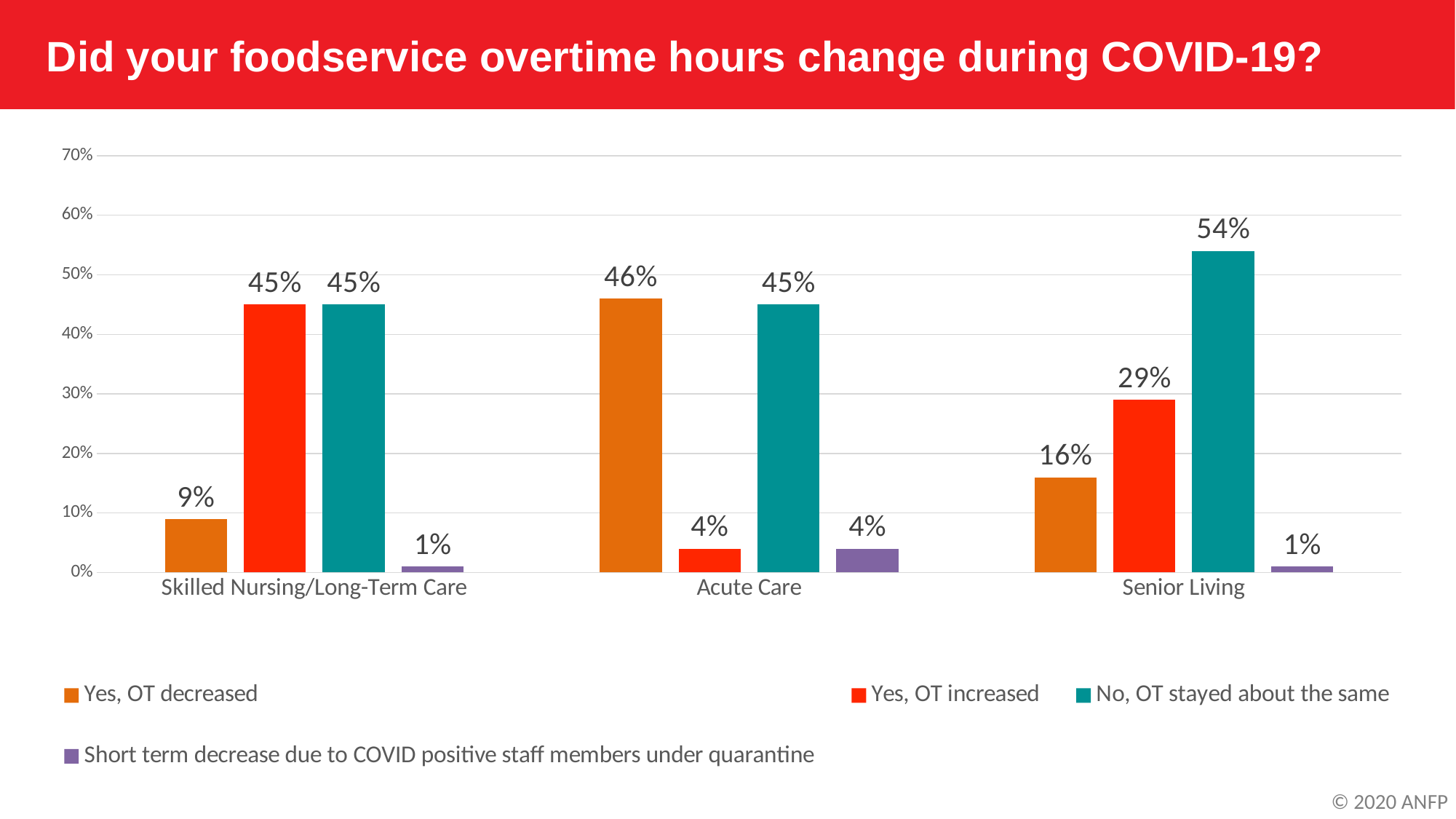
What is the value for 'No, OT stayed about the same' in Senior Living? 54% Which is larger in Acute Care: 'Yes, OT decreased' or 'Yes, OT increased'? Yes, OT decreased What is the value for 'Short term decrease due to COVID positive staff members under quarantine' in Acute Care? 4% Which category has the lowest value for 'Yes, OT increased'? Acute Care Is the value for 'Yes, OT decreased' in Skilled Nursing/Long-Term Care greater or less than 10%? less What kind of chart is shown on the slide? Bar chart Which category has the highest value for 'No, OT stayed about the same'? Senior Living How many categories are shown on the x axis? 3 What is the difference between 'Yes, OT decreased' and 'Yes, OT increased' in Senior Living? 13% What percentage of Skilled Nursing/Long-Term Care respondents said 'Yes, OT increased'? 45% What percentage of Acute Care respondents said 'Yes, OT decreased'? 46% How many series does the legend list? 4